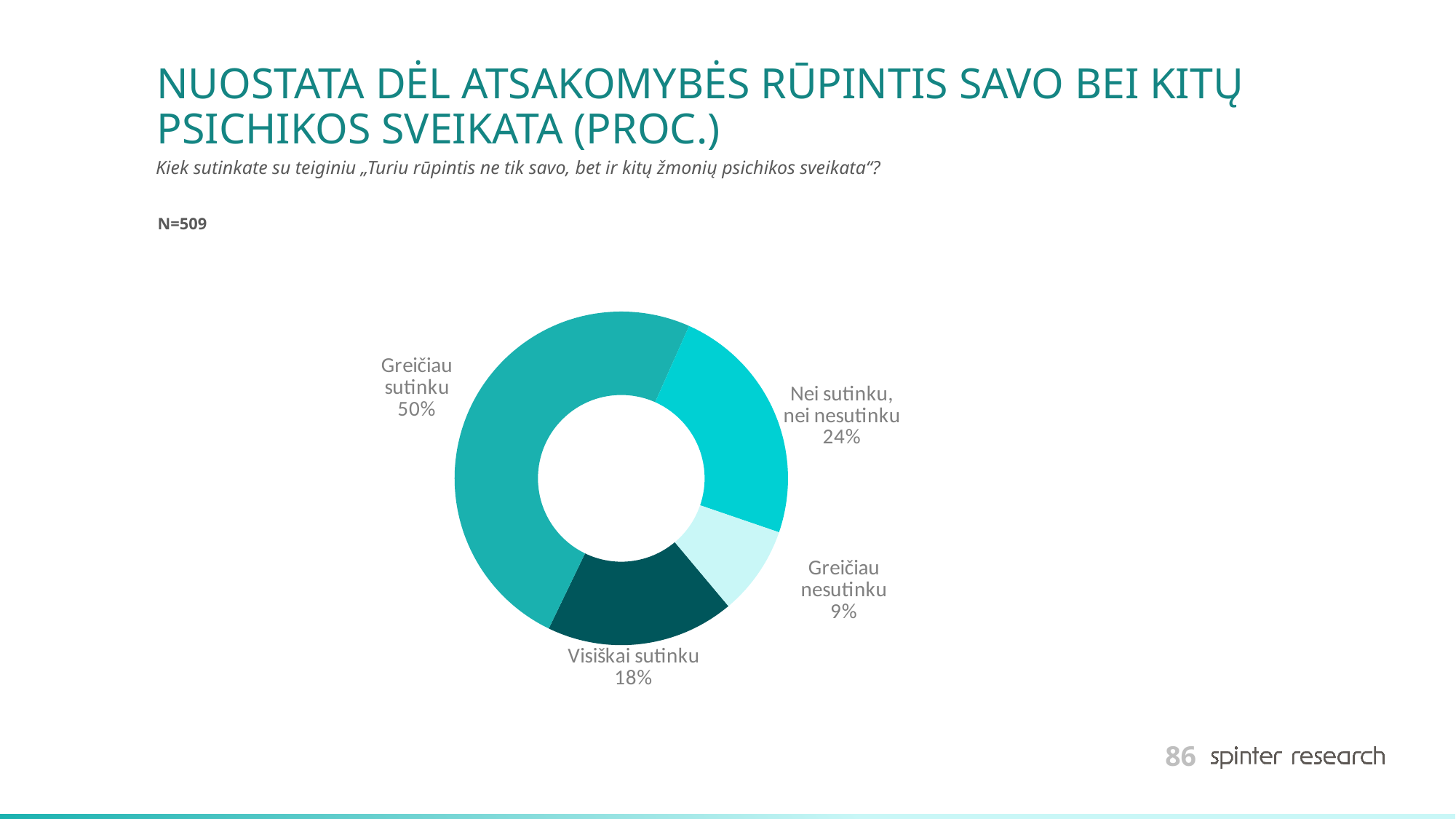
What percentage of respondents answered "Greičiau nesutinku"? 9% What kind of chart is shown on the slide? Pie chart (doughnut) Which is larger: the share for "Nei sutinku, nei nesutinku" or the share for "Visiškai sutinku"? Nei sutinku, nei nesutinku What percentage of respondents answered "Nei sutinku, nei nesutinku"? 24% What percentage of respondents answered "Greičiau sutinku"? 50% What percentage of respondents answered "Visiškai sutinku"? 18% Which response category has the smallest share of the pie? Greičiau nesutinku What is the difference in percentage points between "Greičiau sutinku" and "Visiškai sutinku"? 32 How many response categories are shown in the chart? 4 What is the combined share of "Visiškai sutinku" and "Greičiau sutinku"? 68% Which response category has the largest share of the pie? Greičiau sutinku What is the sample size (N) stated on the slide? N=509